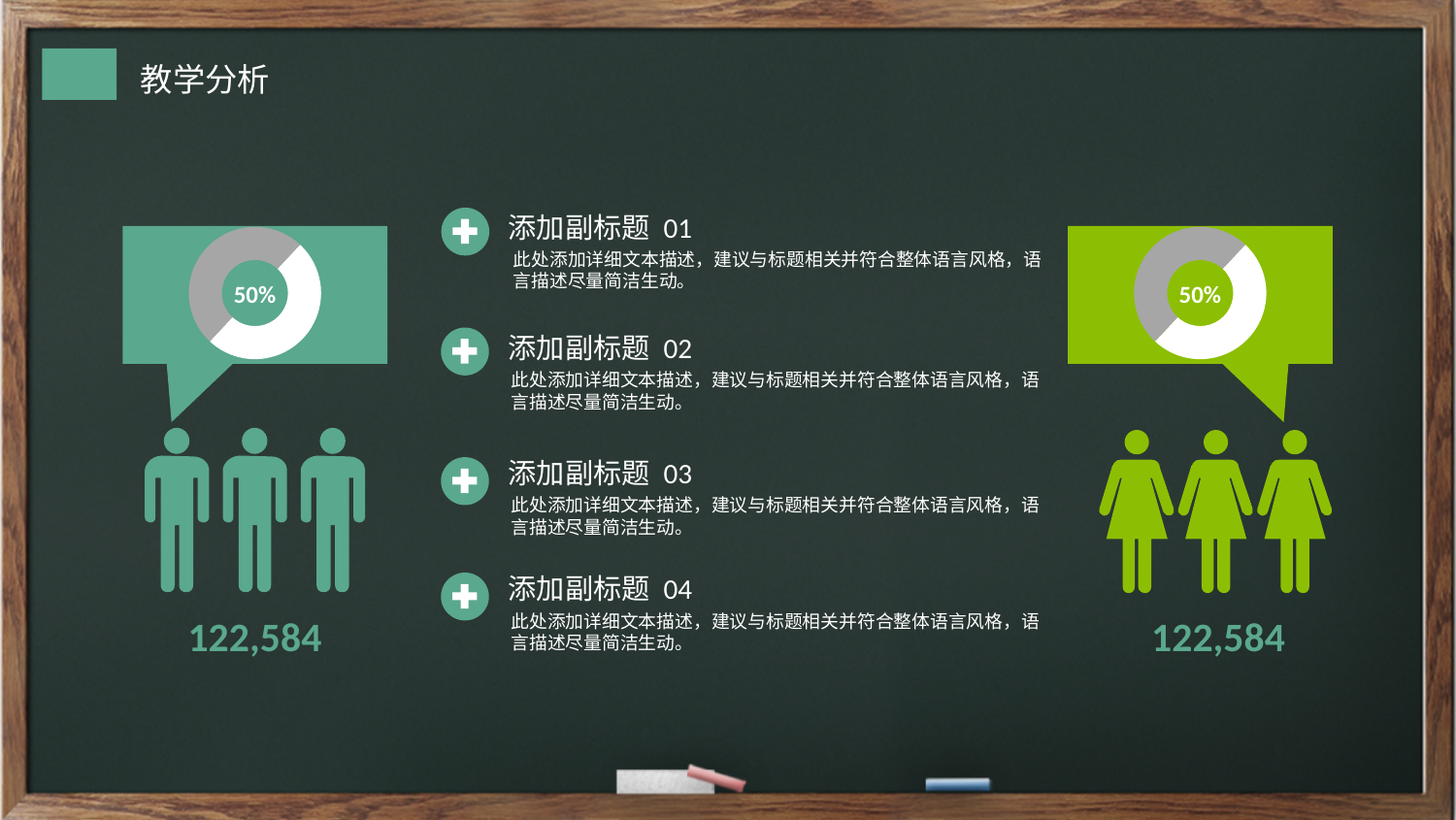
Is the percentage shown in the left donut chart larger than, smaller than, or equal to the percentage shown in the right donut chart? equal What number is printed below the female figures under the right donut chart? 122,584 How many slices does the left donut chart have? 2 What percentage is printed in the centre of the left donut chart? 50% What colour is the filled slice of the right donut chart? green How many slices does the right donut chart have? 2 What colour is the unfilled slice in both donut charts? grey What kind of chart is shown inside the left speech bubble? donut chart What kind of chart is shown inside the right speech bubble? donut chart What percentage is printed in the centre of the right donut chart? 50% What number is printed below the male figures under the left donut chart? 122,584